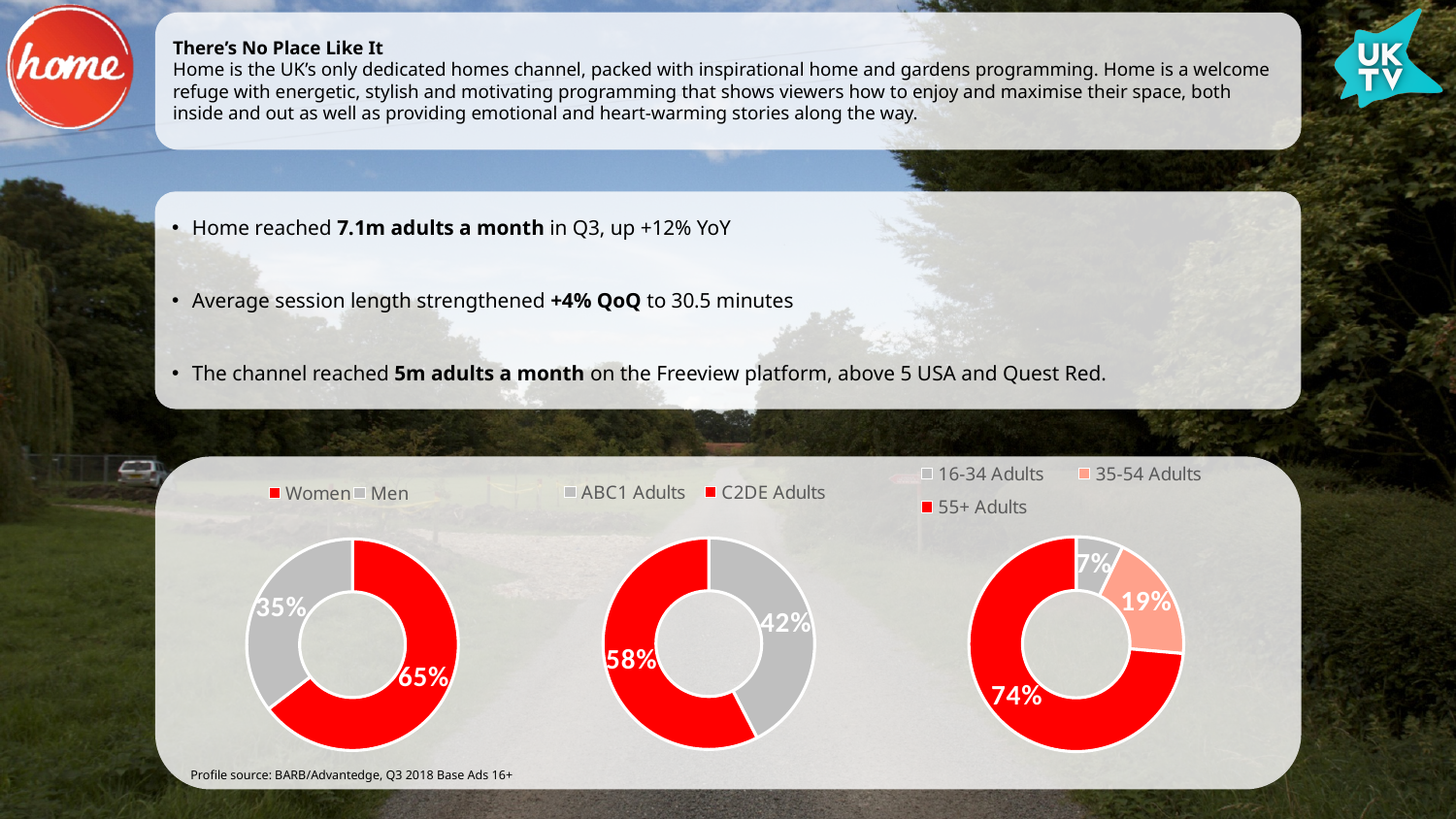
In the left-hand donut chart (Women/Men), what share is Women? 65% In the right-hand donut chart (age groups), which age group has the largest share? 55+ Adults In the left-hand donut chart, what is the difference between the Women and Men shares? 30% In the middle donut chart (ABC1/C2DE Adults), what share is ABC1 Adults? 42% In the left-hand donut chart (Women/Men), what share is Men? 35% In the right-hand donut chart (age groups), what share is 16-34 Adults? 7% In the right-hand donut chart (age groups), which age group has the smallest share? 16-34 Adults What type of chart is used for the Women/Men breakdown on the left? Donut (pie) chart How many series does the legend of the right-hand donut chart list? 3 In the middle donut chart, which is larger, ABC1 Adults or C2DE Adults? C2DE Adults In the right-hand donut chart (age groups), what share is 55+ Adults? 74% In the middle donut chart (ABC1/C2DE Adults), what share is C2DE Adults? 58%